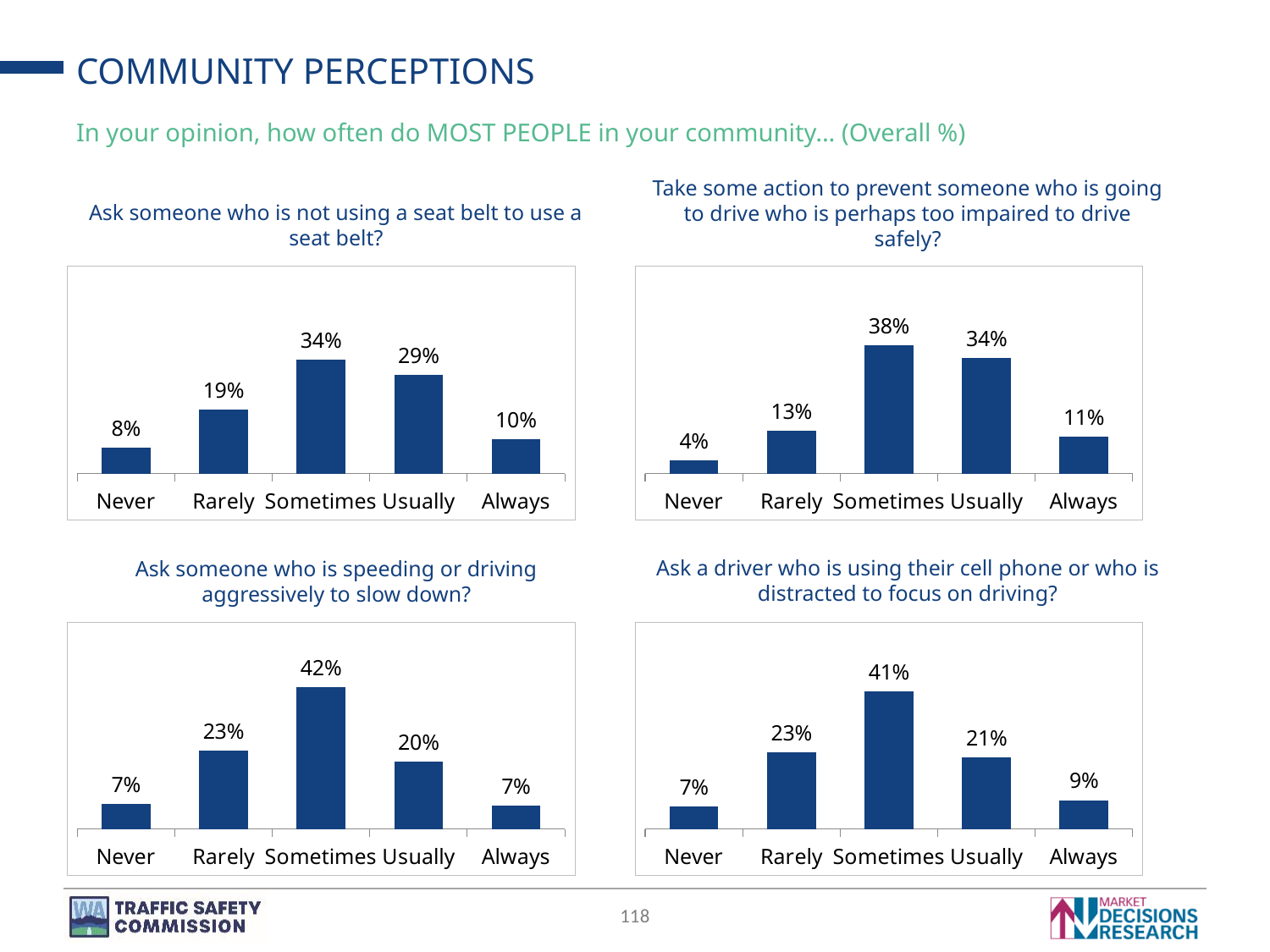
In the cell phone chart (bottom right), which category has the lowest value? Never In the impaired driving chart (top right), what is the value for Never? 4% What kind of chart is the speeding chart (bottom left)? Bar chart How many categories are shown in the cell phone chart (bottom right)? 5 In the seat belt chart (top left), what is the value for Never? 8% In the impaired driving chart (top right), what is the difference between Sometimes and Usually? 4% In the speeding chart (bottom left), what is the difference between Sometimes and Rarely? 19% In the seat belt chart (top left), what is the value for Sometimes? 34% How many charts are on the slide? 4 In the seat belt chart (top left), which is larger, Rarely or Always? Rarely In the speeding chart (bottom left), which category has the highest value? Sometimes In the cell phone chart (bottom right), what is the value for Usually? 21%